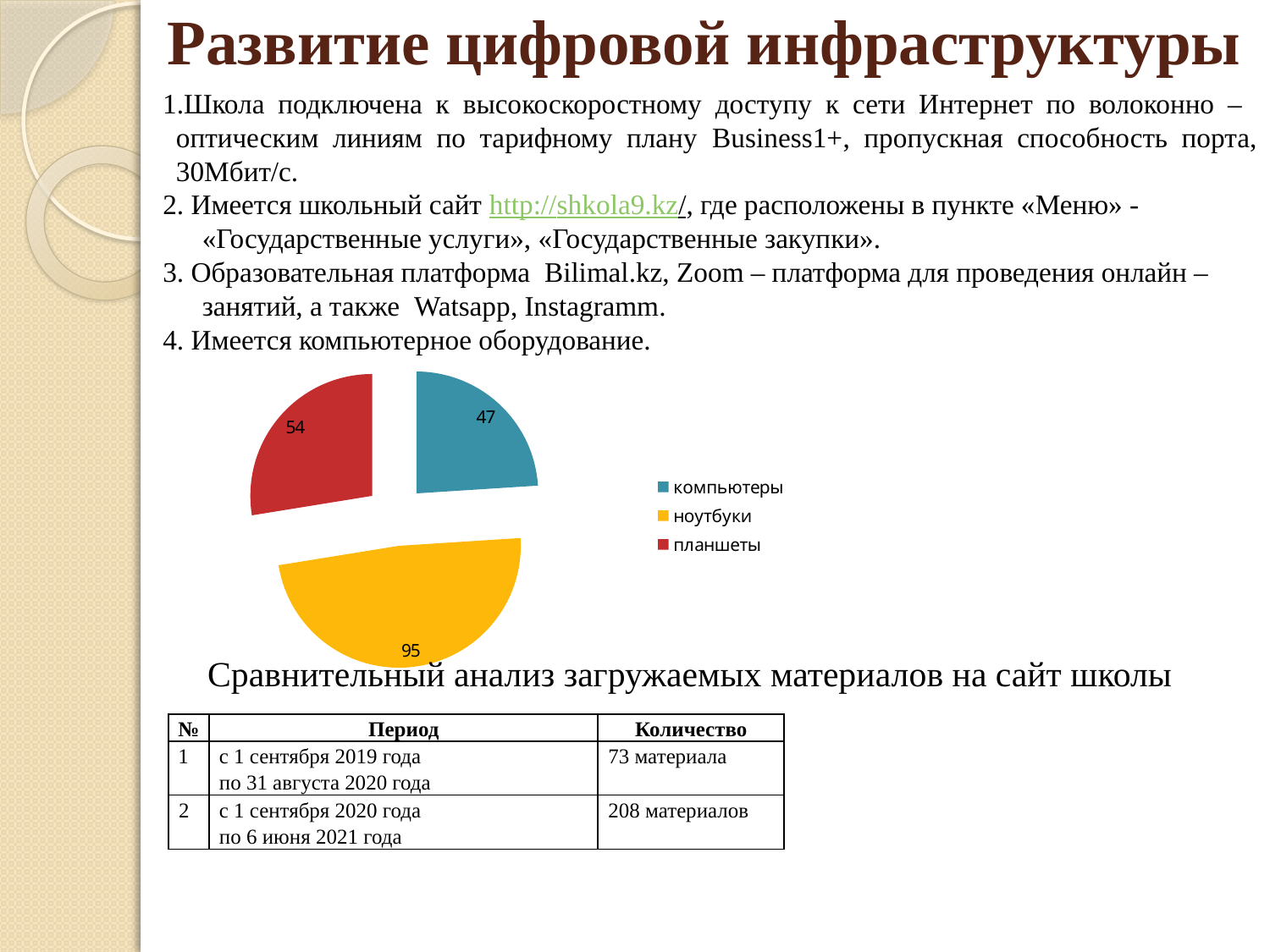
What value is shown for компьютеры in the pie chart? 47 What value is shown for планшеты in the pie chart? 54 What value is shown for ноутбуки in the pie chart? 95 What kind of chart is shown on the slide? pie chart Which category has the smallest slice in the pie chart? компьютеры Which is larger in the pie chart, планшеты or компьютеры? планшеты Which category has the largest slice in the pie chart? ноутбуки How many entries does the legend of the pie chart list? 3 What is the difference between the values for ноутбуки and компьютеры in the pie chart? 48 How many slices does the pie chart have? 3 What is the total of all three slices in the pie chart? 196 What is the difference between the values for планшеты and компьютеры in the pie chart? 7